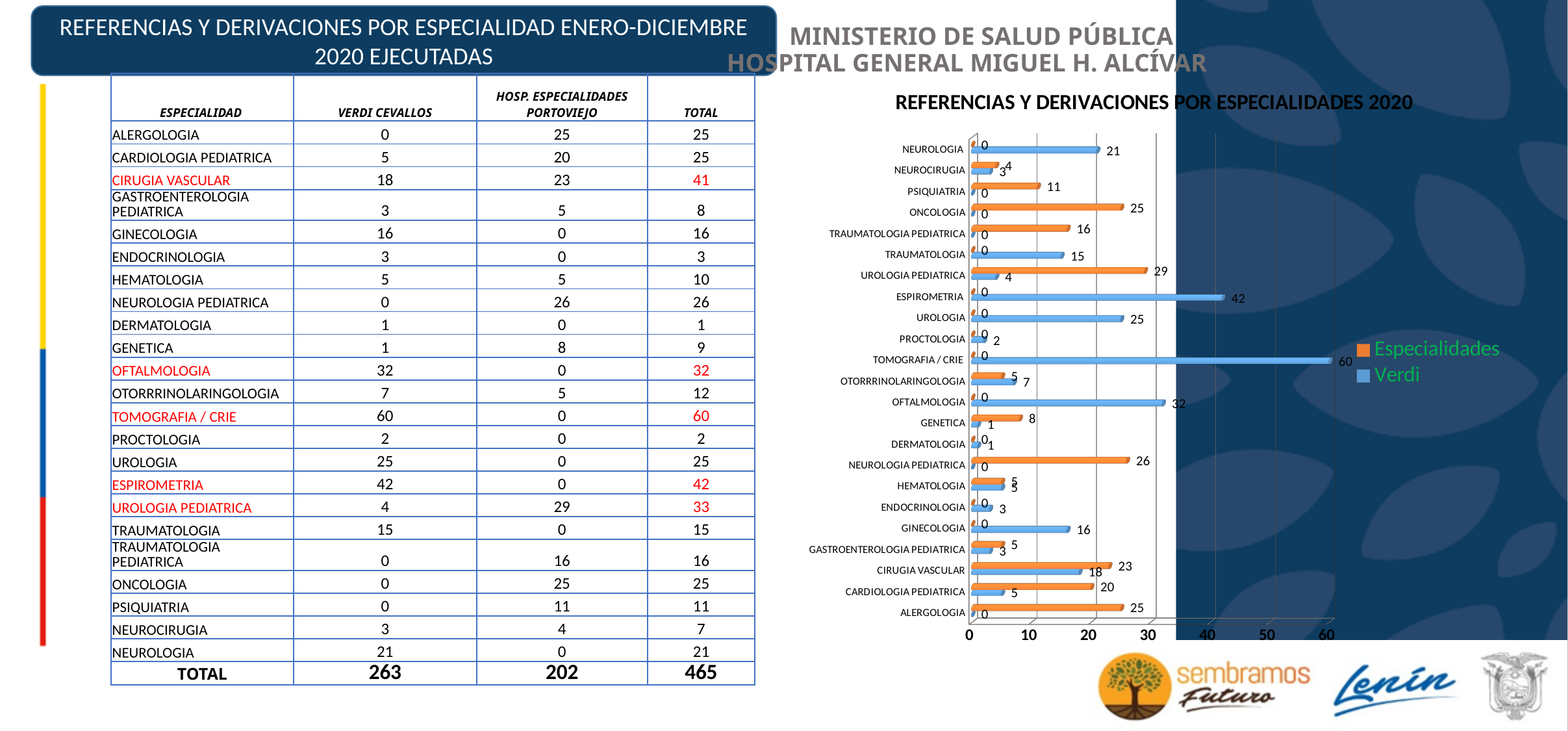
What is the Especialidades value for UROLOGIA PEDIATRICA in the chart? 29 What are the two series named in the chart legend? Especialidades and Verdi What is the Verdi value for TOMOGRAFIA / CRIE in the chart? 60 Which specialty has the highest Especialidades value in the chart? UROLOGIA PEDIATRICA In the chart, what is the difference between the Especialidades and Verdi values for CIRUGIA VASCULAR? 5 In the chart, which is larger for CARDIOLOGIA PEDIATRICA: the Especialidades value or the Verdi value? Especialidades Which specialty has the highest Verdi value in the chart? TOMOGRAFIA / CRIE What is the Especialidades value for NEUROLOGIA PEDIATRICA in the chart? 26 What kind of chart is shown on the slide? bar chart How many series does the chart legend list? 2 What is the Verdi value for ESPIROMETRIA in the chart? 42 How many specialties (categories) are plotted in the chart? 23